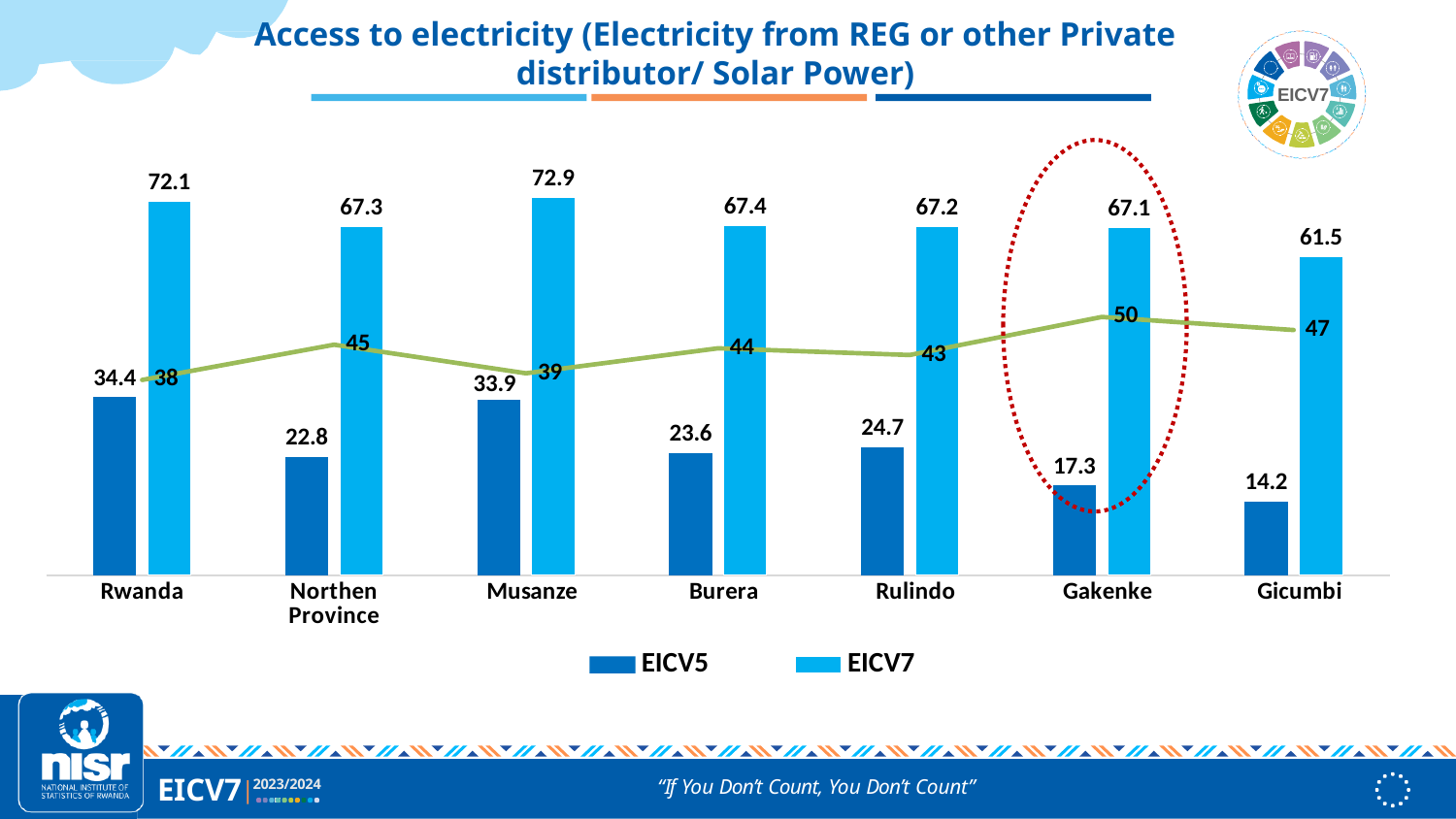
What kind of chart is this? Bar chart with a line What is the EICV5 value for Rwanda? 34.4 What is the difference between the EICV7 and EICV5 values for Northern Province? 44.5 How many series does the legend list? 2 What is the EICV7 value for Gicumbi? 61.5 What value does the green line show for Gakenke? 50 How many categories are shown on the x axis? 7 What is the EICV7 value for Musanze? 72.9 What is the EICV5 value for Gakenke? 17.3 Which is larger, the EICV5 value for Burera or the EICV5 value for Rulindo? Rulindo Which category has the lowest EICV5 value? Gicumbi Which category has the highest EICV7 value? Musanze